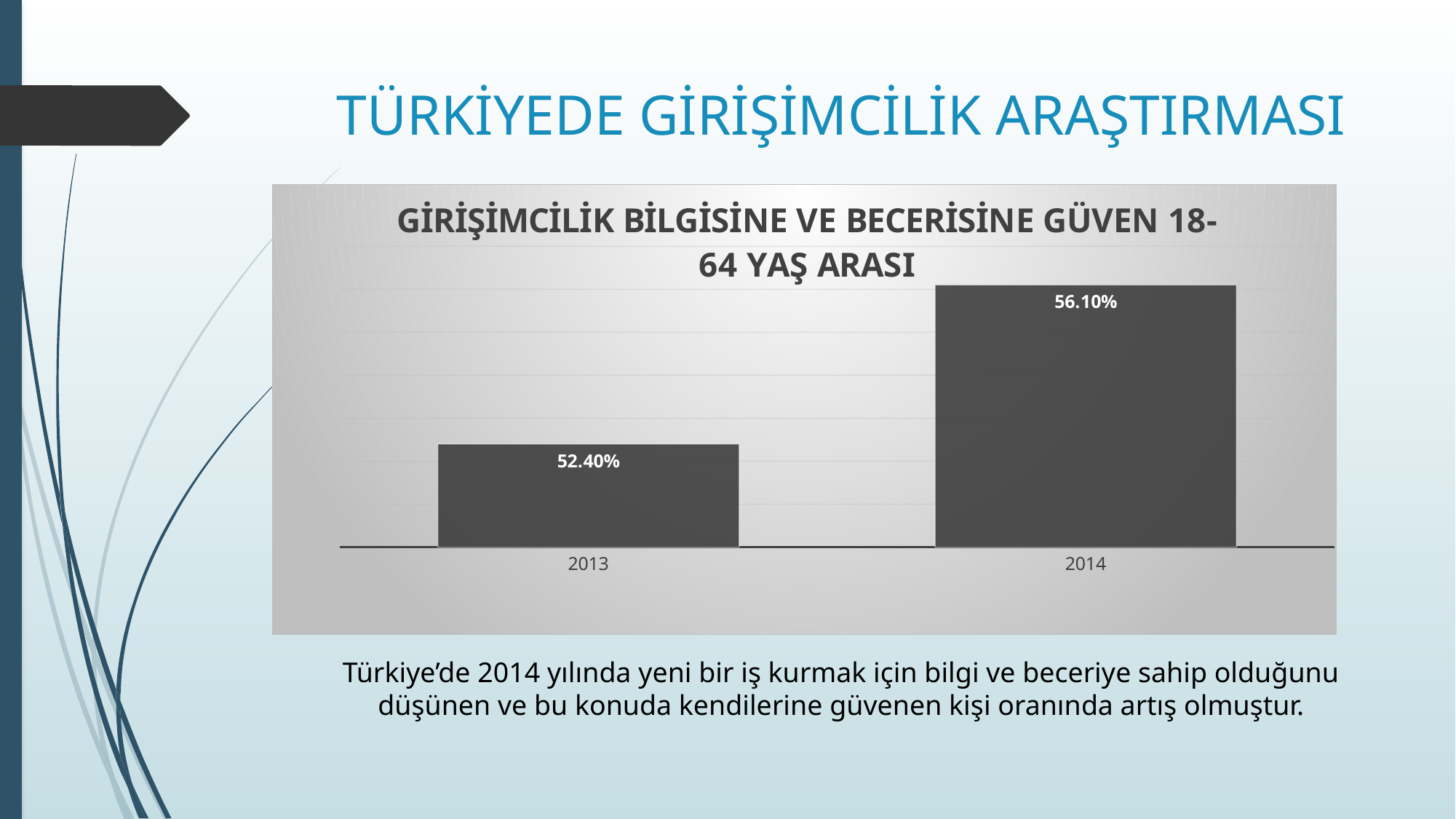
Do the values rise or fall from 2013 to 2014? Rise What colour are the bars in the chart? Dark grey How many categories are shown on the x axis? 2 Which is larger, the value for 2013 or the value for 2014? 2014 What is the value for 2013? 52.40% Which year has the lowest value? 2013 What is the title of the chart? GİRİŞİMCİLİK BİLGİSİNE VE BECERİSİNE GÜVEN 18-64 YAŞ ARASI What is the difference between the 2014 and 2013 values? 3.70% What kind of chart is shown on the slide? Bar chart What is the value for 2014? 56.10% Which year has the highest value? 2014